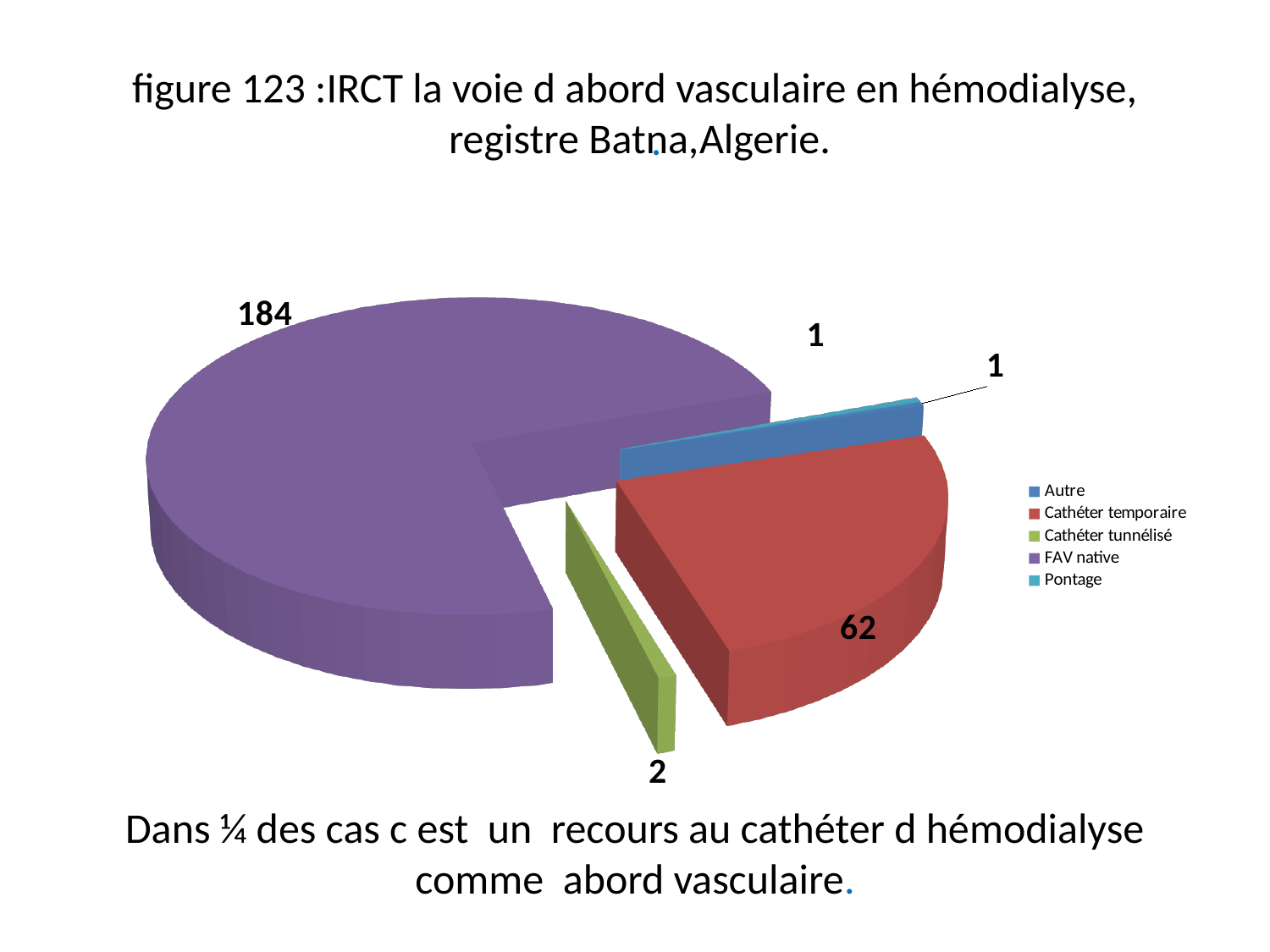
What is the value for Cathéter tunnélisé? 2 What kind of chart is shown on the slide? pie chart What is the total of all the values shown on the pie chart? 250 Which category has the largest slice of the pie? FAV native What is the value for Cathéter temporaire? 62 How many categories does the legend list? 5 What is the value for FAV native? 184 What is the value for Pontage? 1 What is the value for Autre? 1 What colour is the slice for FAV native? purple Which is larger, the value for Cathéter temporaire or the value for Cathéter tunnélisé? Cathéter temporaire What is the difference between the values for FAV native and Cathéter temporaire? 122